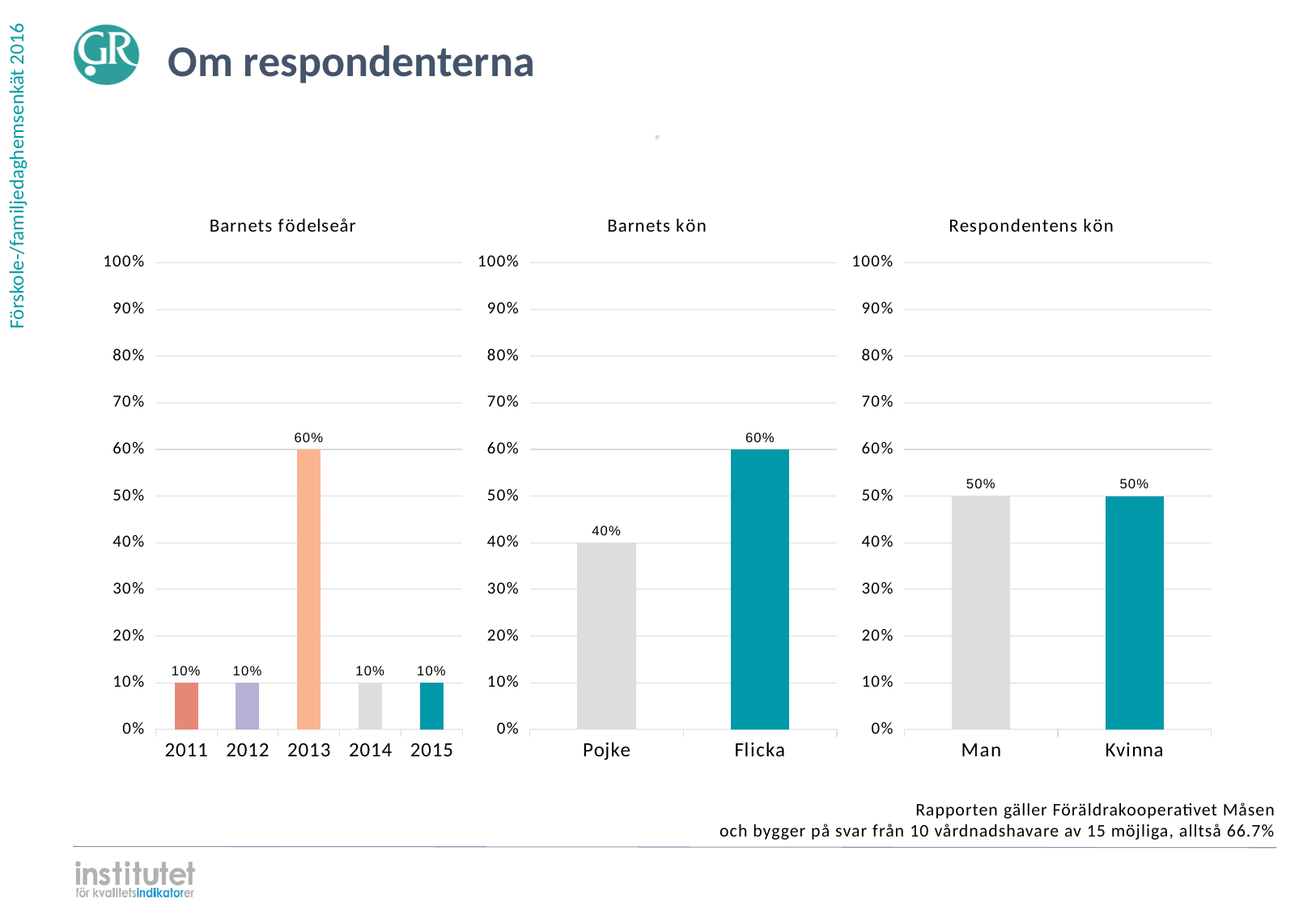
What is the title of the leftmost chart on the slide? Barnets födelseår In the 'Barnets kön' chart, what is the value for Pojke? 40% In the 'Barnets födelseår' chart, what is the difference between the values for 2013 and 2014? 50% In the 'Barnets födelseår' chart, what is the value for 2013? 60% In the 'Barnets kön' chart, which category is larger, Pojke or Flicka? Flicka In the 'Respondentens kön' chart, how many categories are shown? 2 In the 'Barnets födelseår' chart, which birth year has the highest value? 2013 In the 'Barnets födelseår' chart, how many birth-year categories are shown? 5 In the 'Respondentens kön' chart, what is the value for Man? 50% What kind of chart is the 'Barnets kön' chart? Bar chart In the 'Barnets kön' chart, what is the difference between Flicka and Pojke? 20% In the 'Respondentens kön' chart, what is the value for Kvinna? 50%